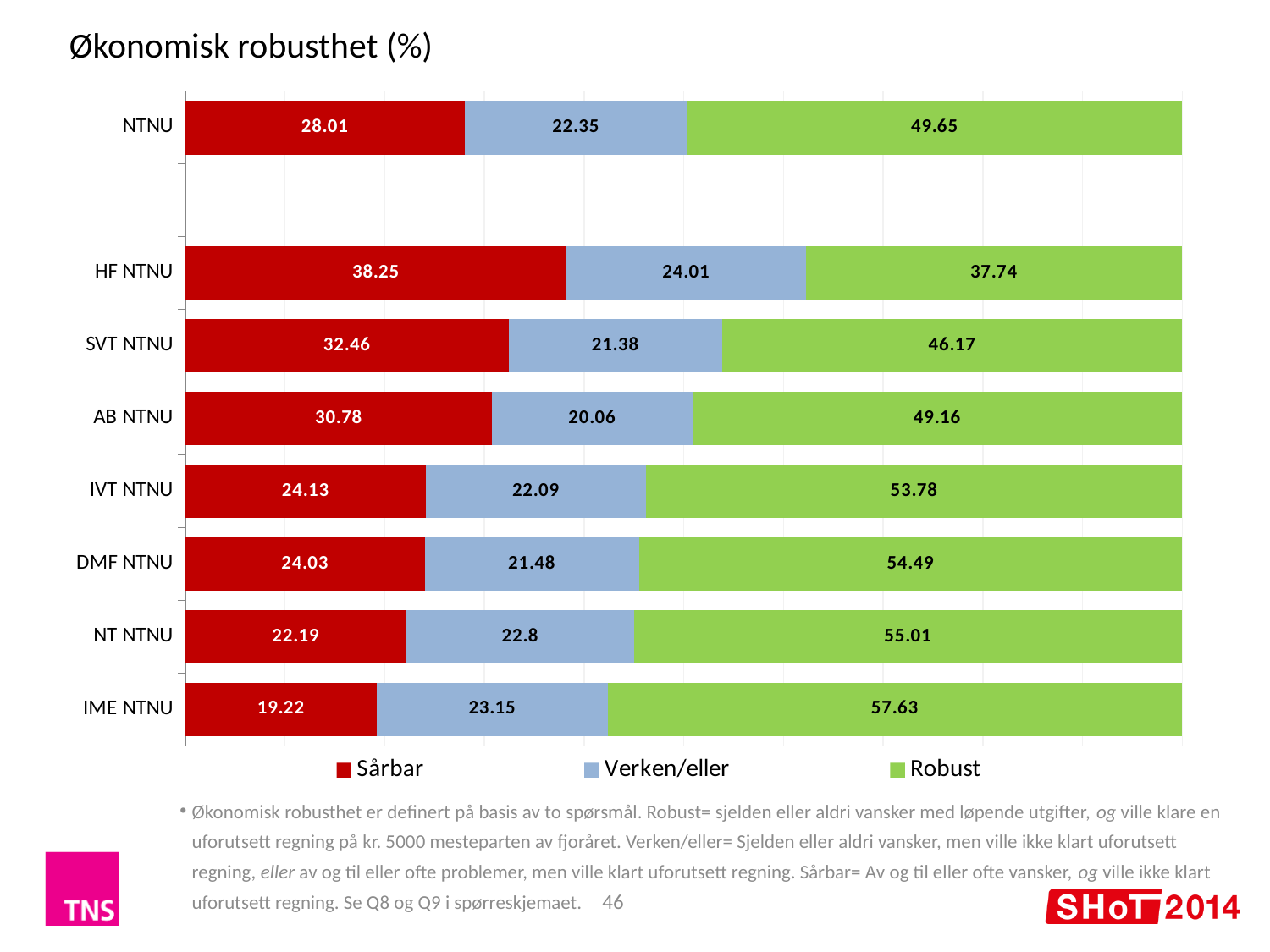
What kind of chart is shown on the slide? Stacked bar chart How many categories are shown on the chart? 8 Which category has the highest Sårbar value? HF NTNU Which category has the lowest Sårbar value? IME NTNU What is the total of the stacked bar for HF NTNU? 100.00 What is the Verken/eller value for NT NTNU? 22.8 How many series does the legend list? 3 What is the Sårbar value for HF NTNU? 38.25 What is the difference between the Sårbar values for HF NTNU and IME NTNU? 19.03 What is the Robust value for IME NTNU? 57.63 Which has the larger Sårbar value, SVT NTNU or AB NTNU? SVT NTNU Which category has the highest Robust value? IME NTNU